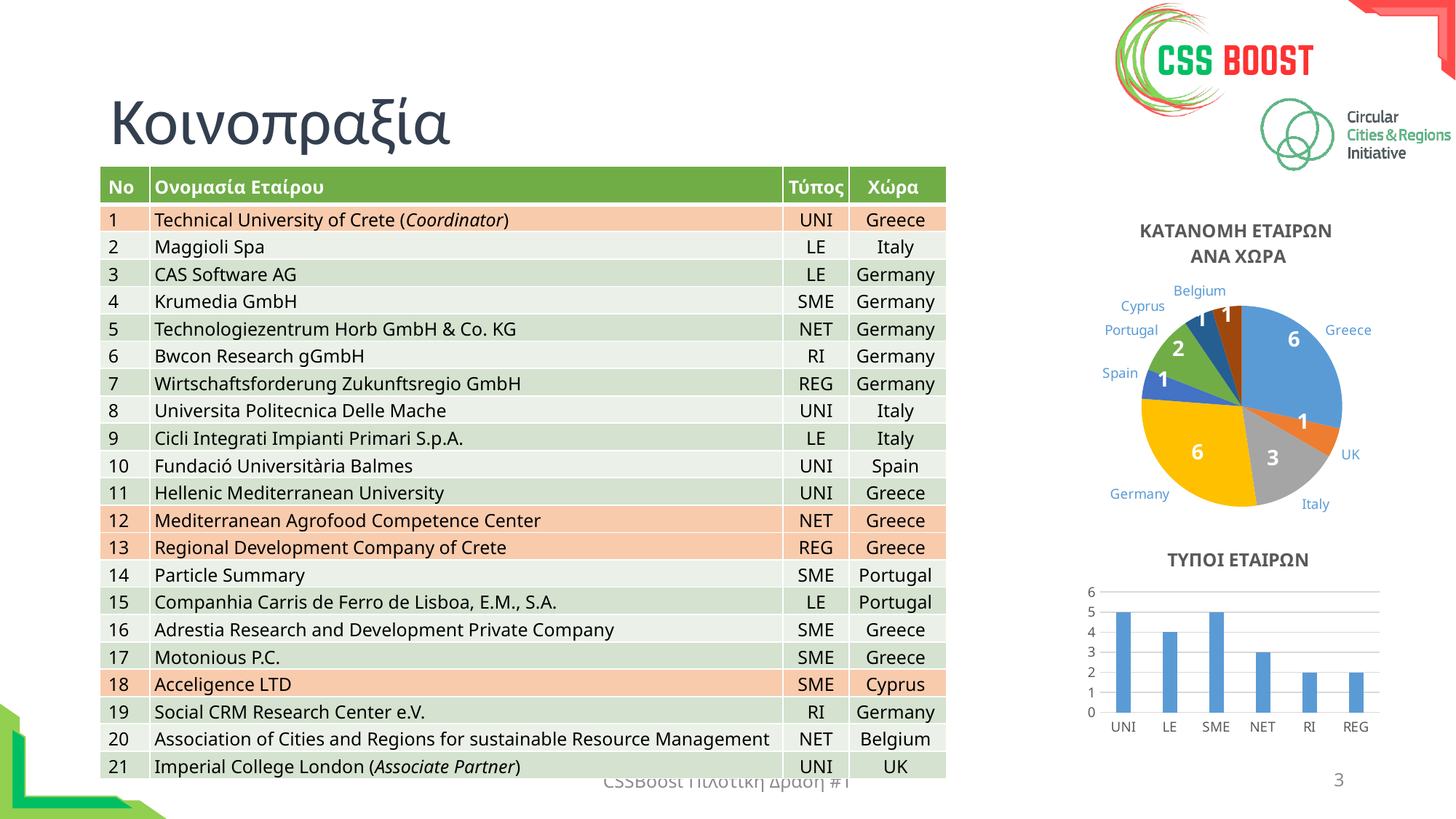
In the pie chart ΚΑΤΑΝΟΜΗ ΕΤΑΙΡΩΝ ΑΝΑ ΧΩΡΑ, how many partners are from Portugal? 2 In the bar chart ΤΥΠΟΙ ΕΤΑΙΡΩΝ, what is the value for LE? 4 In the bar chart ΤΥΠΟΙ ΕΤΑΙΡΩΝ, which category has the lowest value? RI and REG In the bar chart ΤΥΠΟΙ ΕΤΑΙΡΩΝ, how many categories are shown on the x axis? 6 In the bar chart ΤΥΠΟΙ ΕΤΑΙΡΩΝ, is the value for LE greater or less than 3? greater In the bar chart ΤΥΠΟΙ ΕΤΑΙΡΩΝ, what is the value for NET? 3 What type of chart is ΤΥΠΟΙ ΕΤΑΙΡΩΝ? Bar chart In the pie chart ΚΑΤΑΝΟΜΗ ΕΤΑΙΡΩΝ ΑΝΑ ΧΩΡΑ, how many countries are shown? 8 In the pie chart ΚΑΤΑΝΟΜΗ ΕΤΑΙΡΩΝ ΑΝΑ ΧΩΡΑ, how many partners are from Italy? 3 In the pie chart ΚΑΤΑΝΟΜΗ ΕΤΑΙΡΩΝ ΑΝΑ ΧΩΡΑ, what is the difference between the number of partners from Germany and from Italy? 3 In the pie chart ΚΑΤΑΝΟΜΗ ΕΤΑΙΡΩΝ ΑΝΑ ΧΩΡΑ, which has more partners, Portugal or Spain? Portugal What type of chart is ΚΑΤΑΝΟΜΗ ΕΤΑΙΡΩΝ ΑΝΑ ΧΩΡΑ? Pie chart